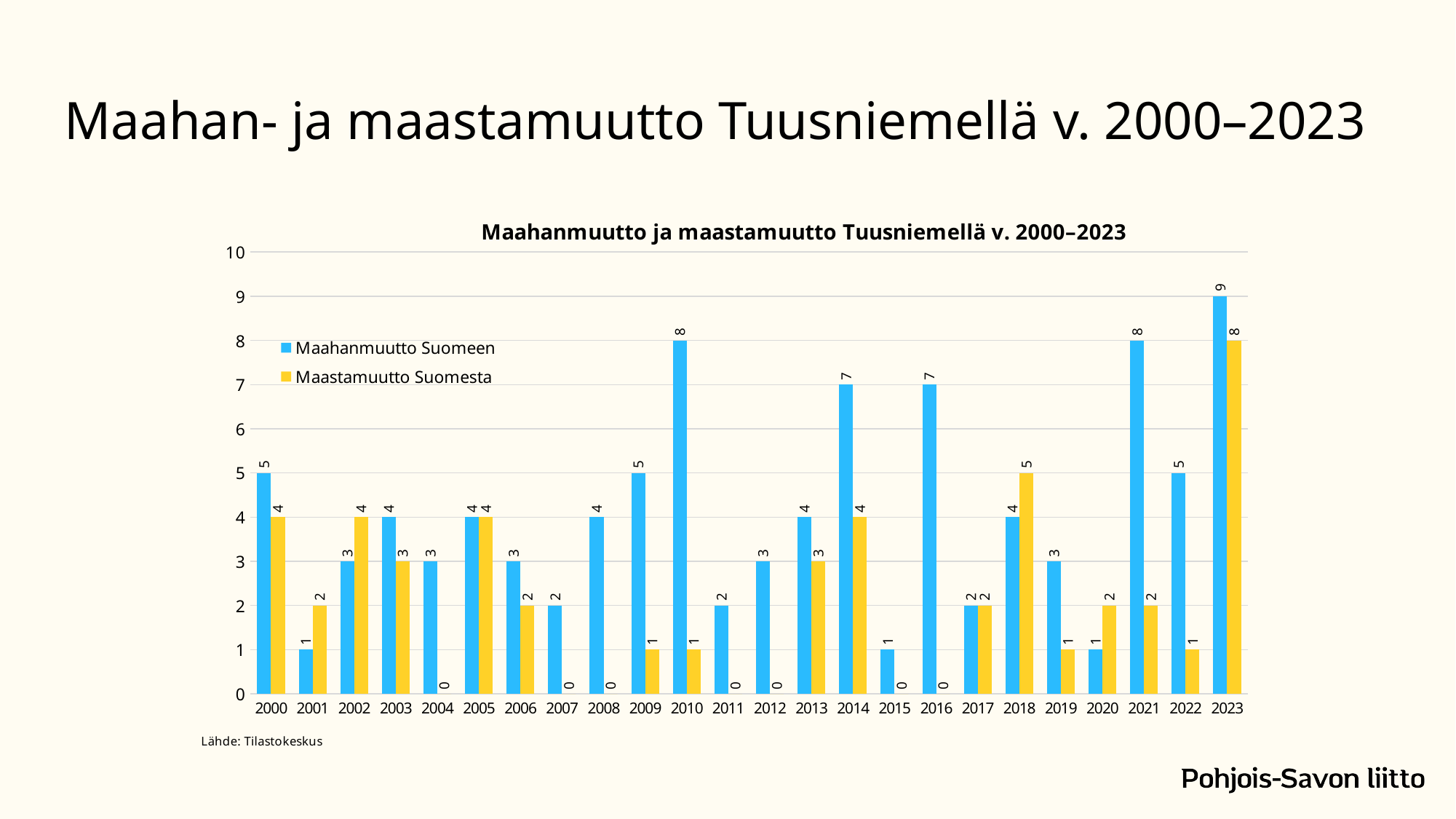
What is the value for Maahanmuutto Suomeen in 2010? 8 In which year is Maahanmuutto Suomeen highest? 2023 What is the difference between Maahanmuutto Suomeen and Maastamuutto Suomesta in 2016? 7 In which year is Maastamuutto Suomesta highest? 2023 Which is larger in 2018, Maahanmuutto Suomeen or Maastamuutto Suomesta? Maastamuutto Suomesta What is the difference between Maahanmuutto Suomeen in 2021 and in 2020? 7 Which is larger in 2014, Maahanmuutto Suomeen or Maastamuutto Suomesta? Maahanmuutto Suomeen What kind of chart is shown on the slide? Bar chart What is the value for Maastamuutto Suomesta in 2018? 5 What is the value for Maastamuutto Suomesta in 2023? 8 How many years are shown on the x axis of the chart? 24 How many series does the chart legend list? 2